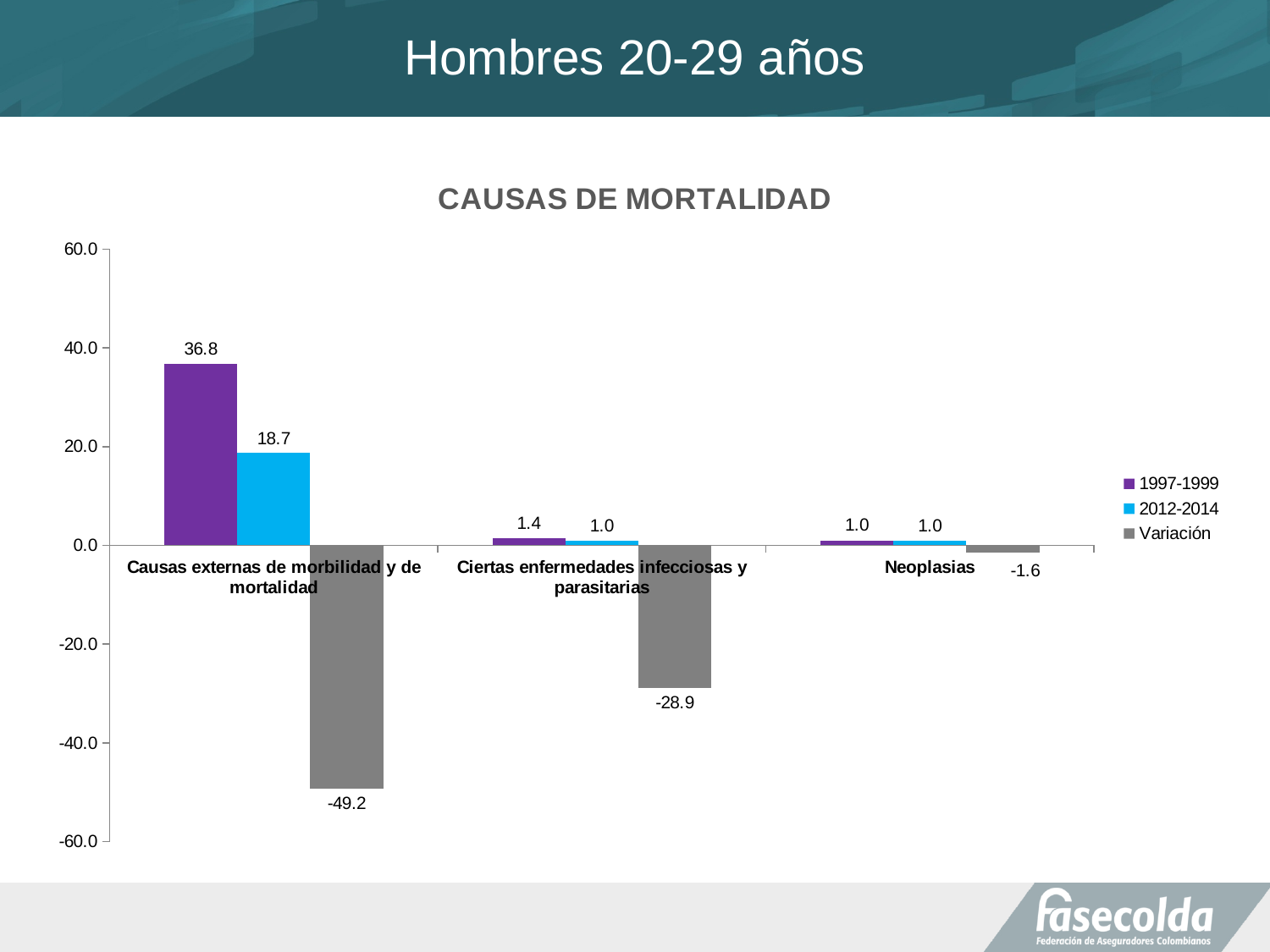
Which is larger for Ciertas enfermedades infecciosas y parasitarias: the 1997-1999 value or the 2012-2014 value? 1997-1999 What kind of chart is shown? Bar chart What is the value for 1997-1999 for Causas externas de morbilidad y de mortalidad? 36.8 What is the Variación value for Ciertas enfermedades infecciosas y parasitarias? -28.9 How many categories are shown on the x axis? 3 What is the Variación value for Neoplasias? -1.6 Which category has the highest 1997-1999 value? Causas externas de morbilidad y de mortalidad What is the value for 2012-2014 for Causas externas de morbilidad y de mortalidad? 18.7 How many series does the legend list? 3 What is the difference between the 1997-1999 and 2012-2014 values for Causas externas de morbilidad y de mortalidad? 18.1 Which category has the lowest Variación value? Causas externas de morbilidad y de mortalidad What is the title of the chart? CAUSAS DE MORTALIDAD